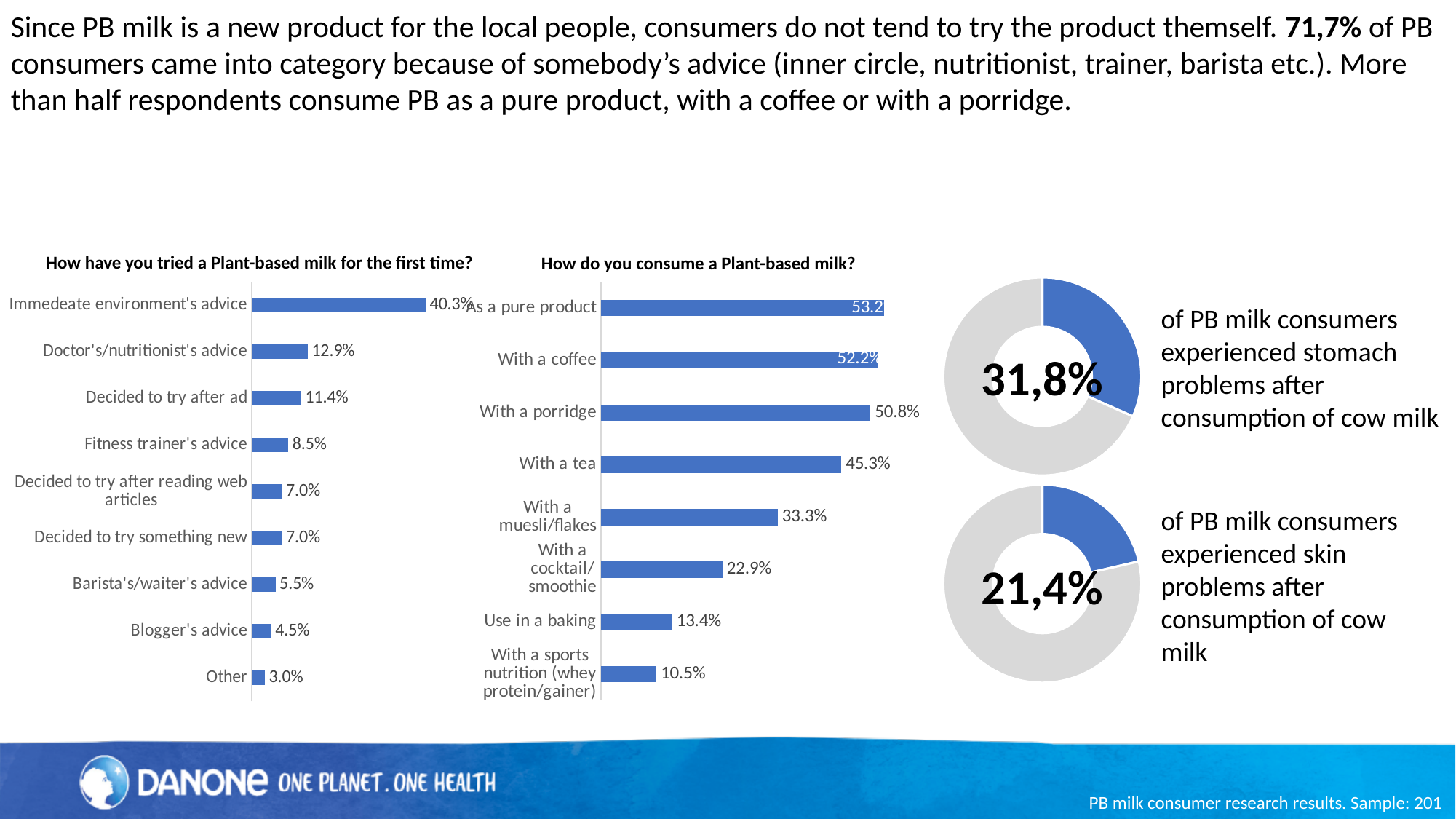
What kind of chart is 'How do you consume a Plant-based milk?'? Bar chart In the chart 'How do you consume a Plant-based milk?', which is larger: With a porridge or With a muesli/flakes? With a porridge According to the upper donut chart on the right, what share of PB milk consumers experienced stomach problems after consumption of cow milk? 31,8% In the chart 'How have you tried a Plant-based milk for the first time?', how many categories are shown? 9 In the chart 'How do you consume a Plant-based milk?', how many categories are shown? 8 In the chart 'How do you consume a Plant-based milk?', what is the value for Use in a baking? 13.4% In the chart 'How have you tried a Plant-based milk for the first time?', which category has the lowest value? Other In the chart 'How have you tried a Plant-based milk for the first time?', what is the value for Doctor's/nutritionist's advice? 12.9% In the chart 'How do you consume a Plant-based milk?', what is the value for With a tea? 45.3% In the chart 'How have you tried a Plant-based milk for the first time?', which category has the highest value? Immedeate environment's advice In the chart 'How do you consume a Plant-based milk?', which category has the lowest value? With a sports nutrition (whey protein/gainer) In the chart 'How have you tried a Plant-based milk for the first time?', what is the difference between Immedeate environment's advice and Doctor's/nutritionist's advice? 27.4%